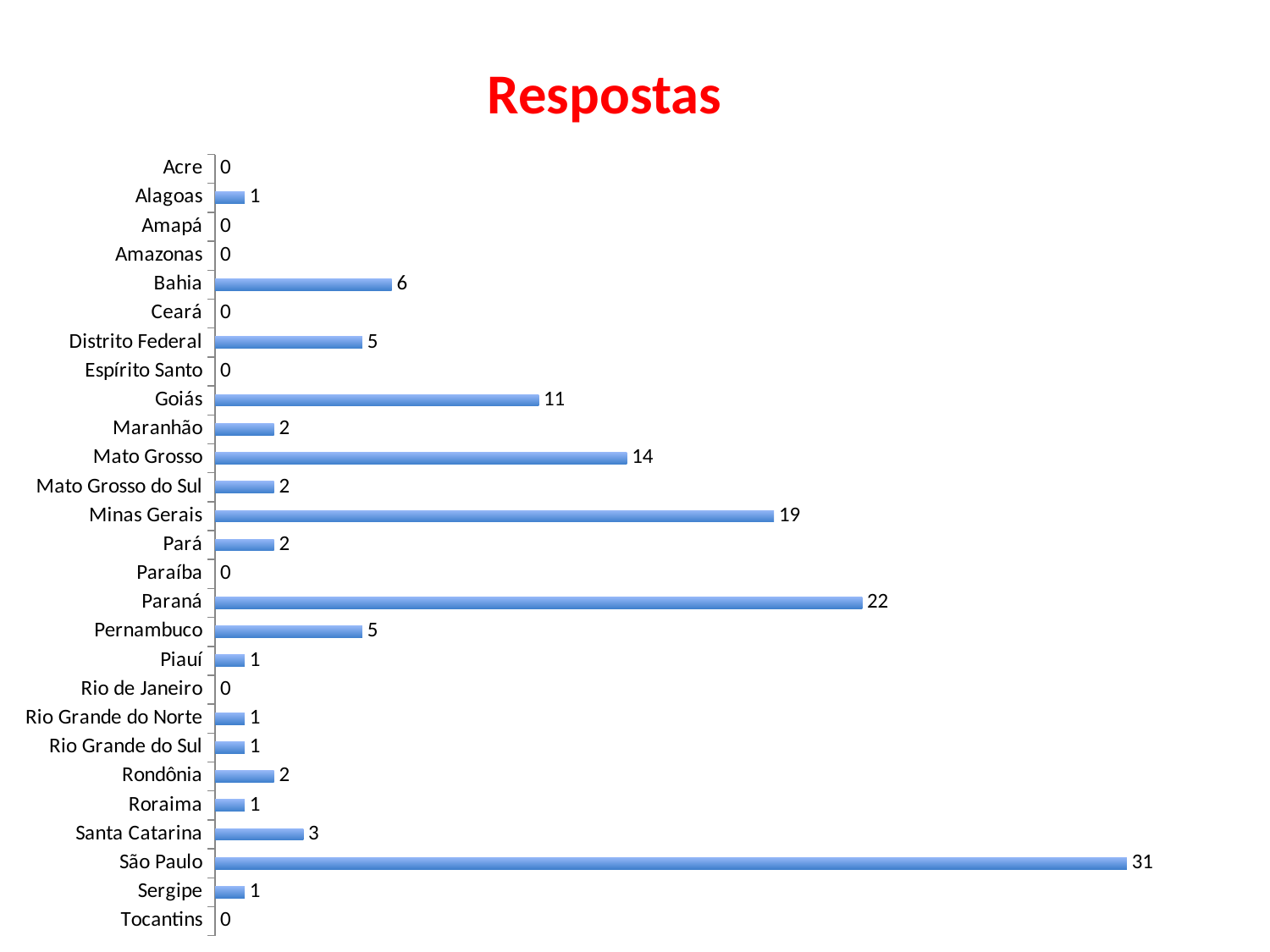
What is the value for Minas Gerais? 19 Which has a larger value, Paraná or Minas Gerais? Paraná What is the difference between the values for Mato Grosso and Bahia? 8 What is the difference between the values for São Paulo and Paraná? 9 Which state has the highest value? São Paulo What kind of chart is shown on the slide? Bar chart How many states have a value of 0? 8 How many states are listed on the chart? 27 Which has a larger value, Santa Catarina or Pernambuco? Pernambuco What is the value for Distrito Federal? 5 What is the value for São Paulo? 31 What is the value for Goiás? 11